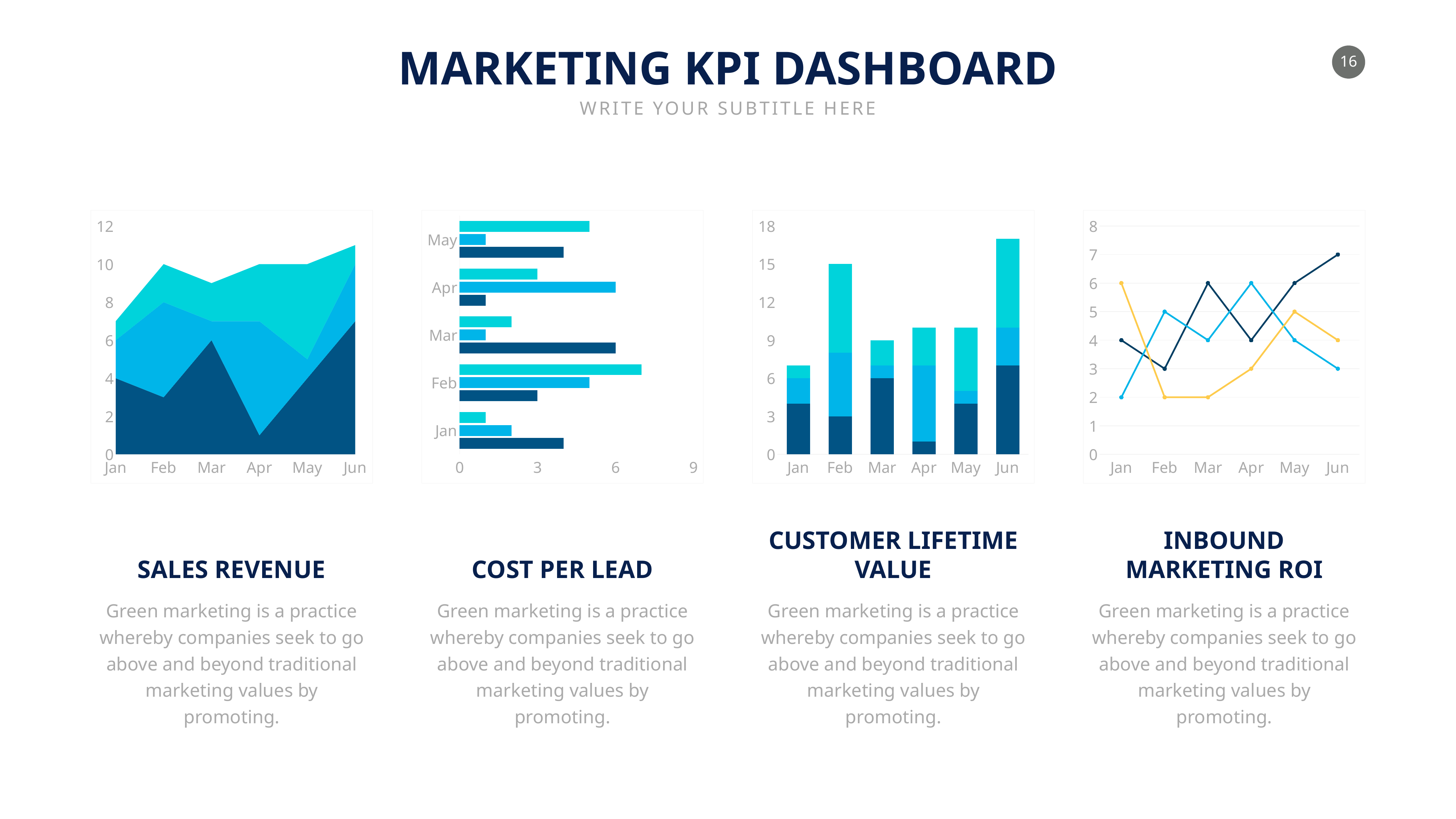
In the Cost Per Lead chart, is the longest bar for Feb greater or less than 6? greater What kind of chart is the Inbound Marketing ROI chart? Line chart What kind of chart is the Sales Revenue chart? Area chart In the Customer Lifetime Value chart, which month has the tallest stacked bar? Jun What kind of chart is the Customer Lifetime Value chart? Bar chart How many months are listed on the Cost Per Lead chart? 5 How many months are shown on the x axis of the Sales Revenue chart? 6 In the Customer Lifetime Value chart, which month has the shortest stacked bar? Jan How many lines are plotted in the Inbound Marketing ROI chart? 3 In the Sales Revenue chart, is the top of the stacked area in Jun greater or less than 10? greater In the Customer Lifetime Value chart, is the total for Jun greater or less than 15? greater